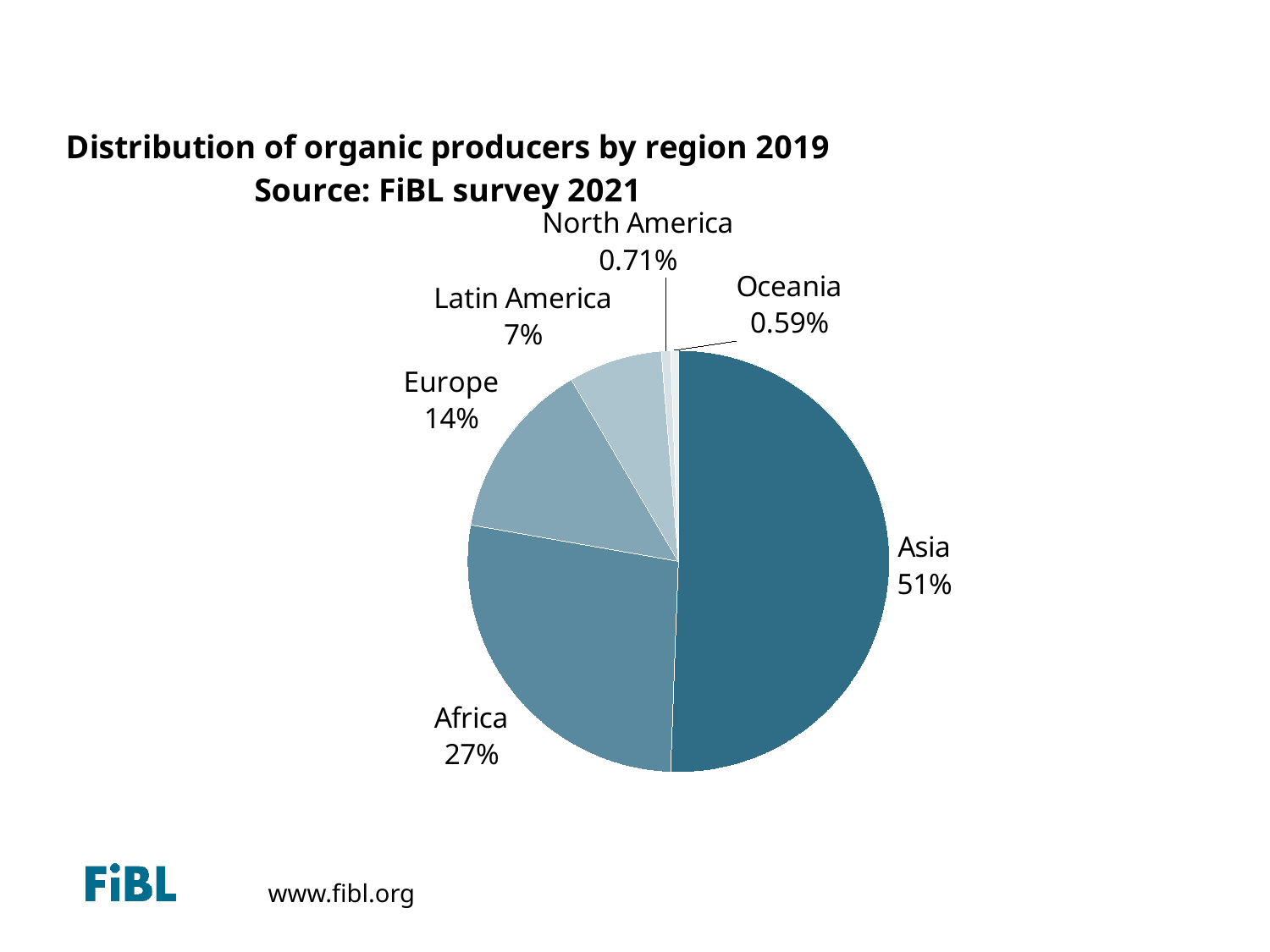
What share of organic producers is in North America? 0.71% What is the difference in percentage points between Asia's and Africa's shares? 24 Which region has the largest share of organic producers? Asia What type of chart is shown on the slide? Pie chart Which has a larger share of organic producers, Europe or Latin America? Europe Which region has the smallest share of organic producers? Oceania What share of organic producers is in Europe? 14% What share of organic producers is in Oceania? 0.59% What share of organic producers is in Asia? 51% What share of organic producers is in Latin America? 7% What share of organic producers is in Africa? 27% How many regions are shown in the pie chart? 6